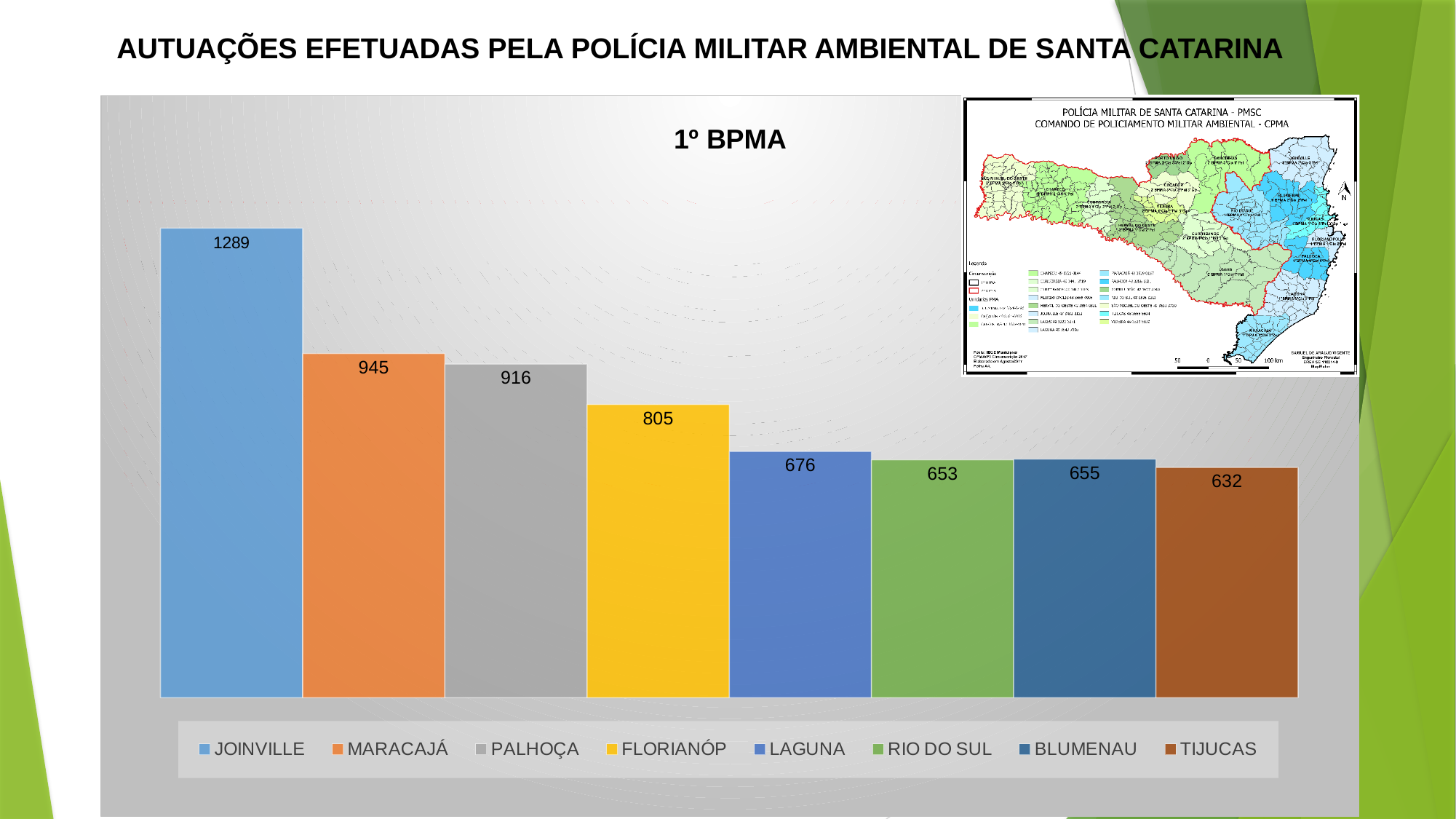
How many bars are plotted in the 1º BPMA chart? 8 Which category has the lowest value in the 1º BPMA chart? TIJUCAS Which category has the highest value in the 1º BPMA chart? JOINVILLE What is the difference between the values for JOINVILLE and MARACAJÁ in the 1º BPMA chart? 344 What is the value for FLORIANÓP in the 1º BPMA chart? 805 What is the value for JOINVILLE in the 1º BPMA chart? 1289 How many entries does the legend of the 1º BPMA chart list? 8 What kind of chart is the 1º BPMA chart? bar chart Which is larger in the 1º BPMA chart, the value for MARACAJÁ or the value for PALHOÇA? MARACAJÁ What is the value for TIJUCAS in the 1º BPMA chart? 632 What colour is the bar for FLORIANÓP in the 1º BPMA chart? yellow What is the difference between the values for PALHOÇA and LAGUNA in the 1º BPMA chart? 240